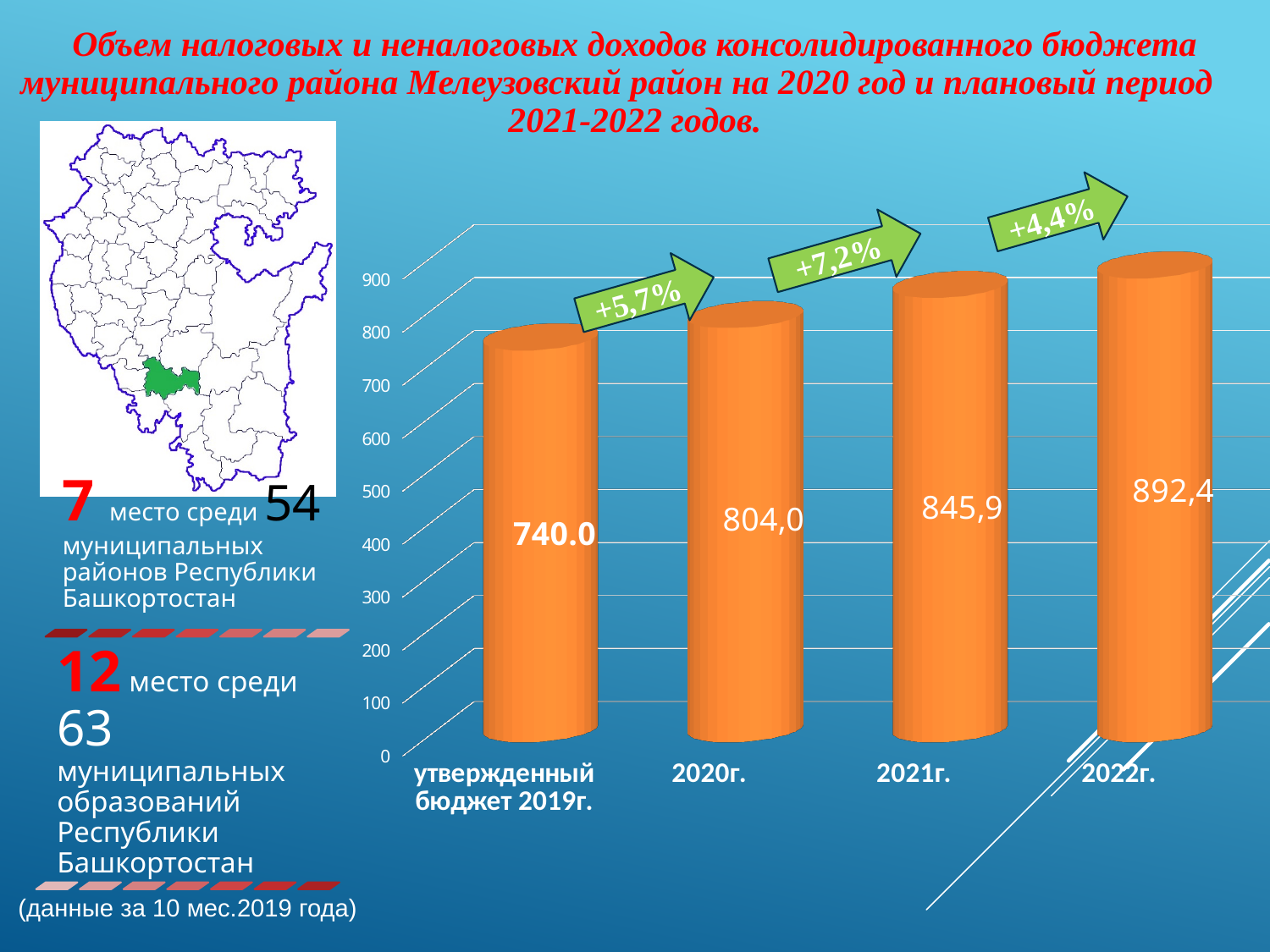
Which is larger, the value for 2020г. or the value for 2021г.? 2021г. What kind of chart is shown on the slide? bar chart Which category has the highest value? 2022г. Do the values rise or fall from left to right along the x axis? rise How many categories are shown on the x axis? 4 What is the value for 2022г.? 892,4 What is the value for 2021г.? 845,9 What is the value for 2020г.? 804,0 What is the difference between the values for 2022г. and 2021г.? 46,5 What is the value for the утвержденный бюджет 2019г. category? 740.0 What is the difference between the values for 2021г. and 2020г.? 41,9 Which category has the lowest value? утвержденный бюджет 2019г.